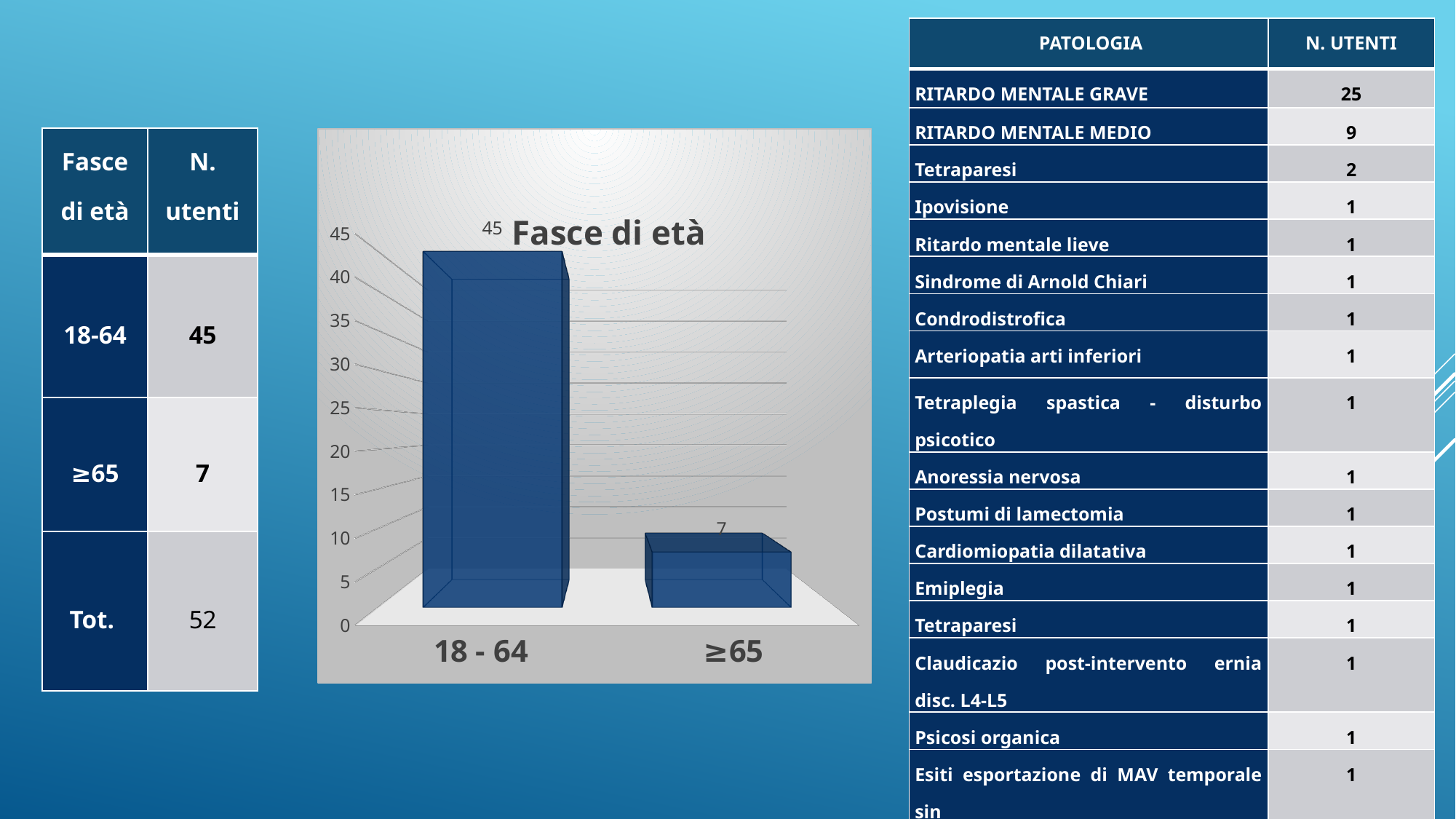
What is the title of the chart on the slide? Fasce di età Which category has the lowest value in the Fasce di età chart? ≥65 What is the value for the 18 - 64 category in the Fasce di età chart? 45 Which category has the highest value in the Fasce di età chart? 18 - 64 What kind of chart is the Fasce di età chart? bar chart Is the value for ≥65 in the Fasce di età chart greater or less than 10? less What is the value for the ≥65 category in the Fasce di età chart? 7 Which is larger in the Fasce di età chart, the value for 18 - 64 or for ≥65? 18 - 64 What is the maximum value shown on the vertical axis of the Fasce di età chart? 45 Is the value for 18 - 64 in the Fasce di età chart greater or less than 40? greater How many categories are shown in the Fasce di età chart? 2 What is the difference between the 18 - 64 and ≥65 values in the Fasce di età chart? 38